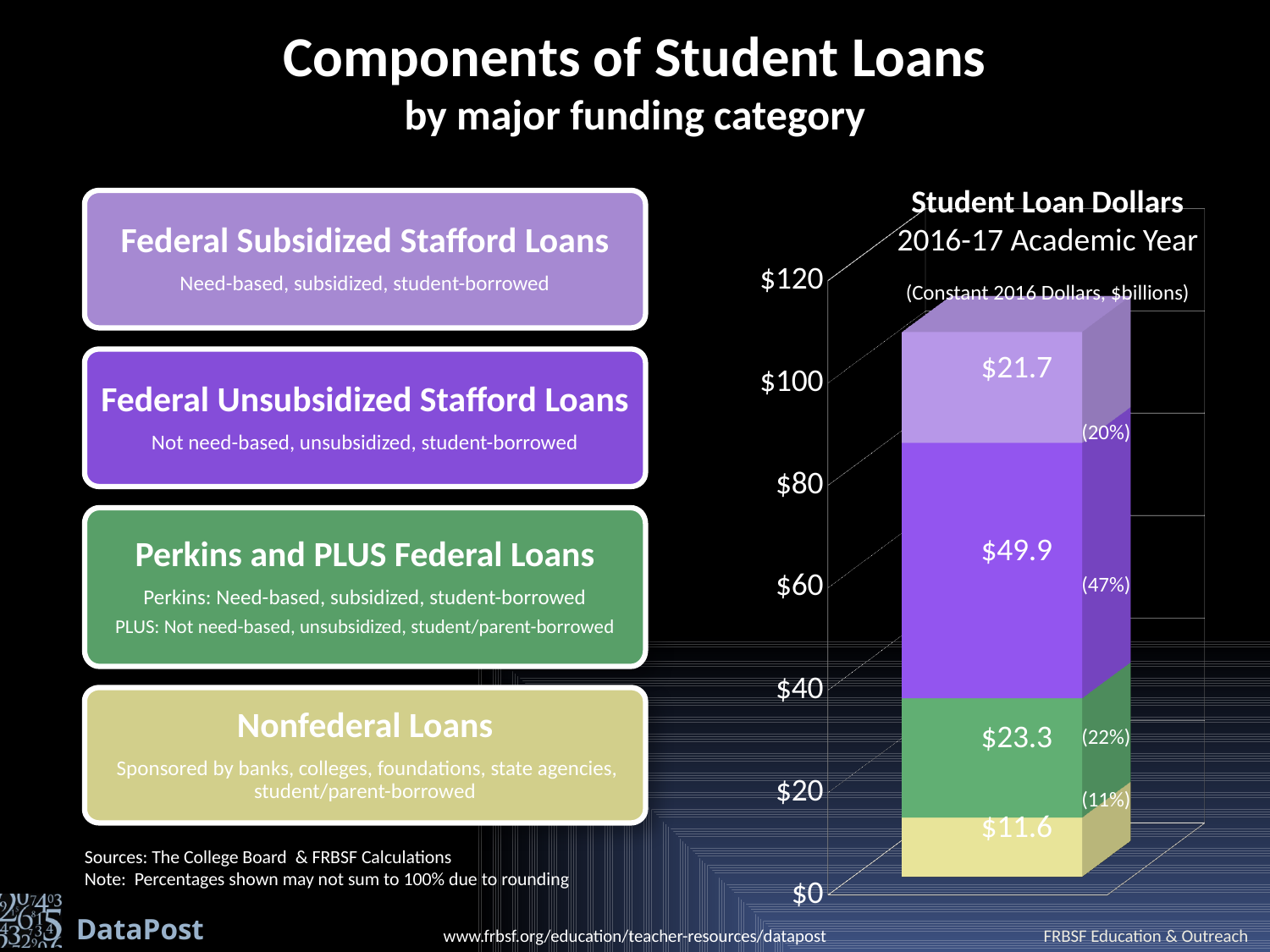
Which is larger: the Perkins and PLUS Federal Loans segment or the Federal Subsidized Stafford Loans segment? Perkins and PLUS Federal Loans What percentage share of the stacked bar is labeled for the Federal Unsubsidized Stafford Loans segment? 47% What value is shown for the green segment (Perkins and PLUS Federal Loans) in the stacked bar? $23.3 What value is shown for the light purple segment (Federal Subsidized Stafford Loans) at the top of the stacked bar? $21.7 What value is shown for the yellow segment (Nonfederal Loans) at the bottom of the stacked bar? $11.6 What is the difference between the Federal Unsubsidized Stafford Loans segment ($49.9) and the Perkins and PLUS Federal Loans segment ($23.3)? $26.6 What kind of chart is shown on the slide? Stacked bar chart What is the title of the chart on the slide? Student Loan Dollars Which loan category has the smallest segment in the stacked bar? Nonfederal Loans What is the value of the purple segment labeled $49.9 in the stacked bar, which corresponds to Federal Unsubsidized Stafford Loans? $49.9 What is the total of all four segments in the stacked bar? $106.5 Which loan category has the largest segment in the stacked bar? Federal Unsubsidized Stafford Loans